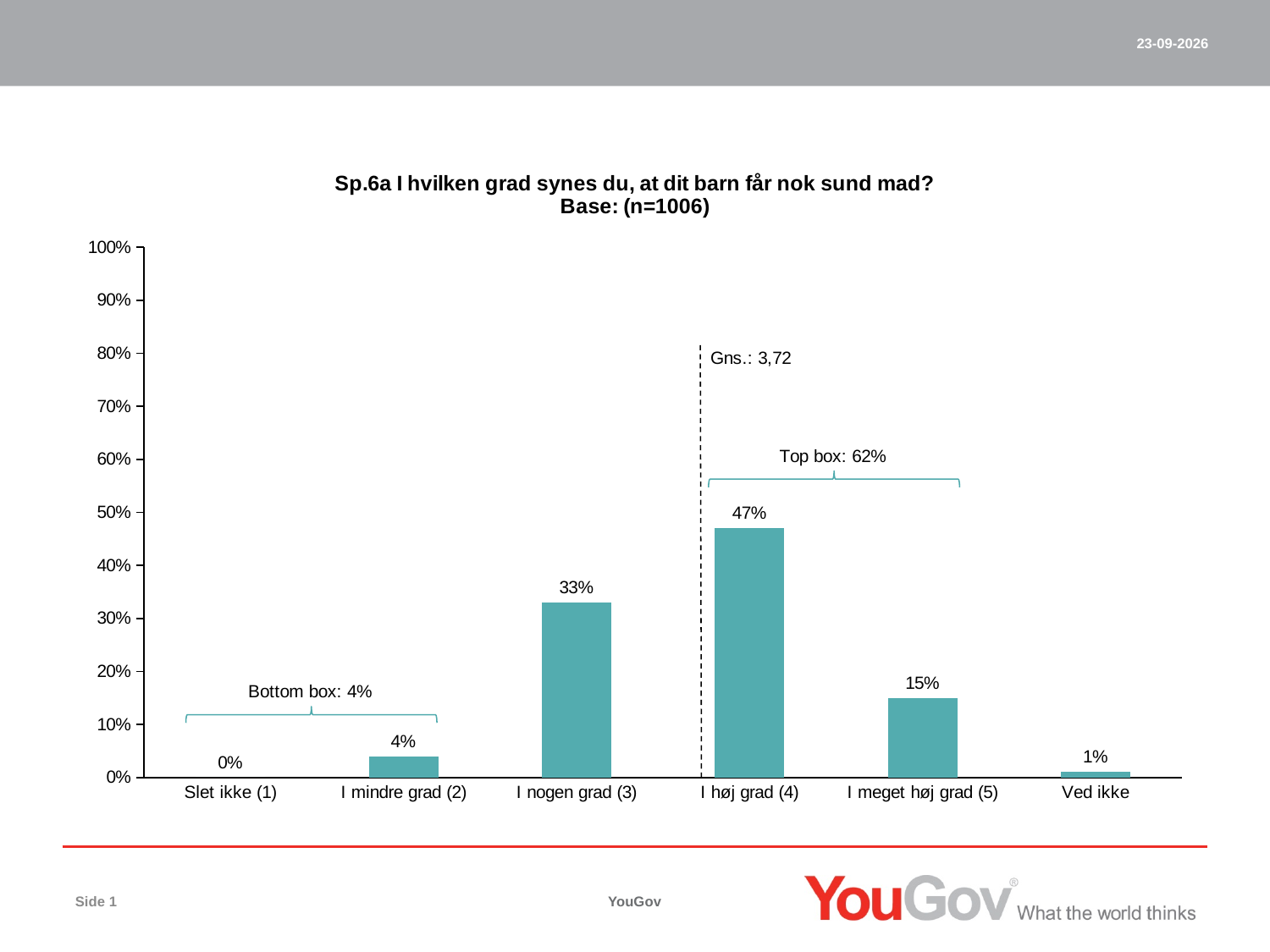
What is the value for "Ved ikke"? 1% What is the average (Gns.) value shown on the chart? 3,72 What is the Top box value shown on the chart? 62% What is the value for "I nogen grad (3)"? 33% Which is larger, the value for "I nogen grad (3)" or "I meget høj grad (5)"? I nogen grad (3) Is the value for "I høj grad (4)" greater or less than 40%? greater What kind of chart is shown on the slide? Bar chart Which category has the lowest value? Slet ikke (1) What is the value for "I høj grad (4)"? 47% What is the difference between the values for "I høj grad (4)" and "I meget høj grad (5)"? 32% Which category has the highest value? I høj grad (4) How many categories are shown on the x axis? 6